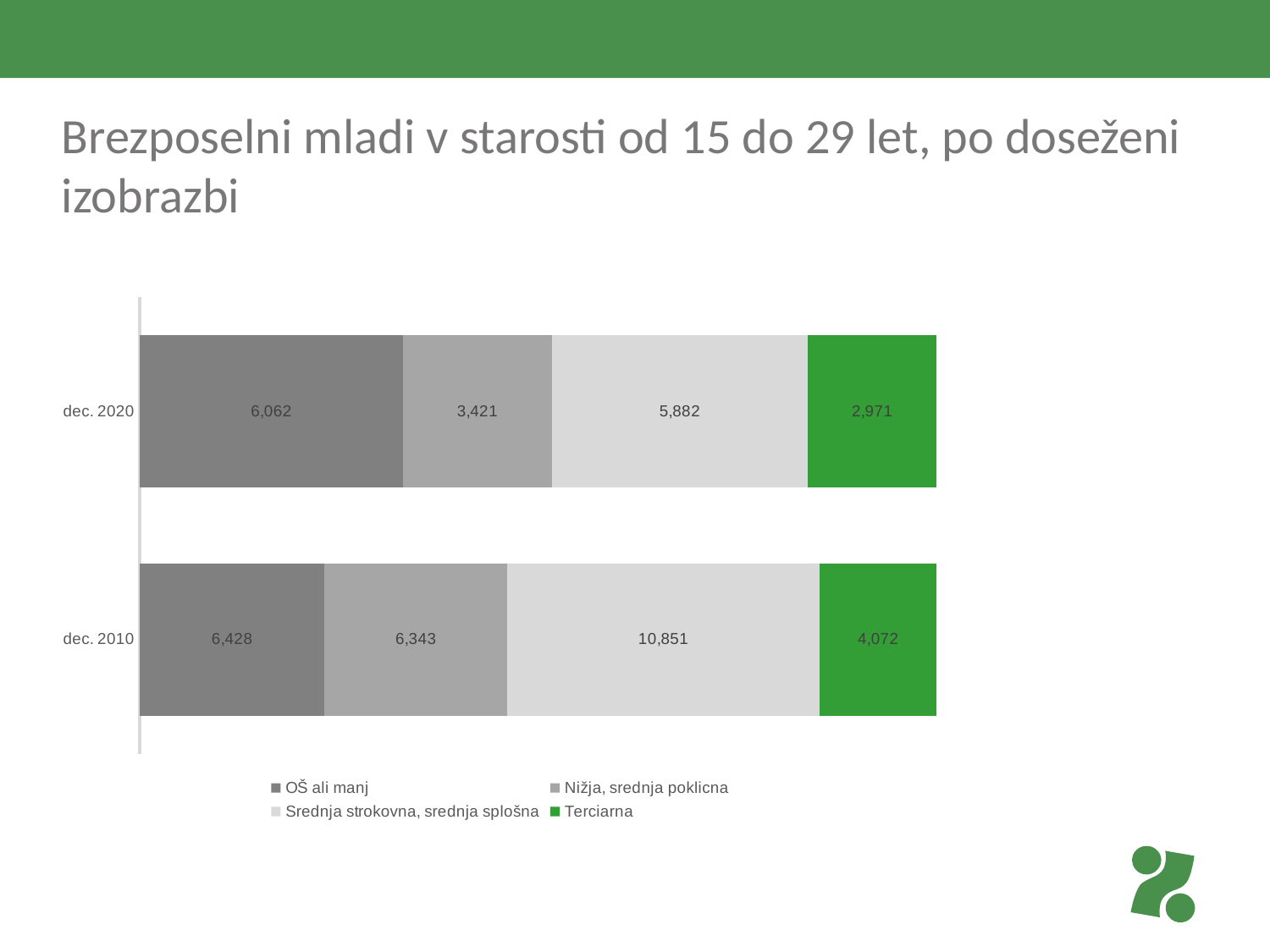
Which is larger: Nižja, srednja poklicna in dec. 2010 or in dec. 2020? dec. 2010 How many categories (time points) are shown on the chart? 2 What kind of chart is shown on the slide? Stacked bar chart How many series does the legend list? 4 What is the difference between the Terciarna values for dec. 2010 and dec. 2020? 1,101 What is the value for Terciarna in dec. 2020? 2,971 What is the value for Srednja strokovna, srednja splošna in dec. 2010? 10,851 What is the value for OŠ ali manj in dec. 2020? 6,062 Which education group has the highest value in dec. 2010? Srednja strokovna, srednja splošna What is the total of the stacked bar for dec. 2020? 18,336 Which education group has the lowest value in dec. 2020? Terciarna What is the value for Nižja, srednja poklicna in dec. 2010? 6,343